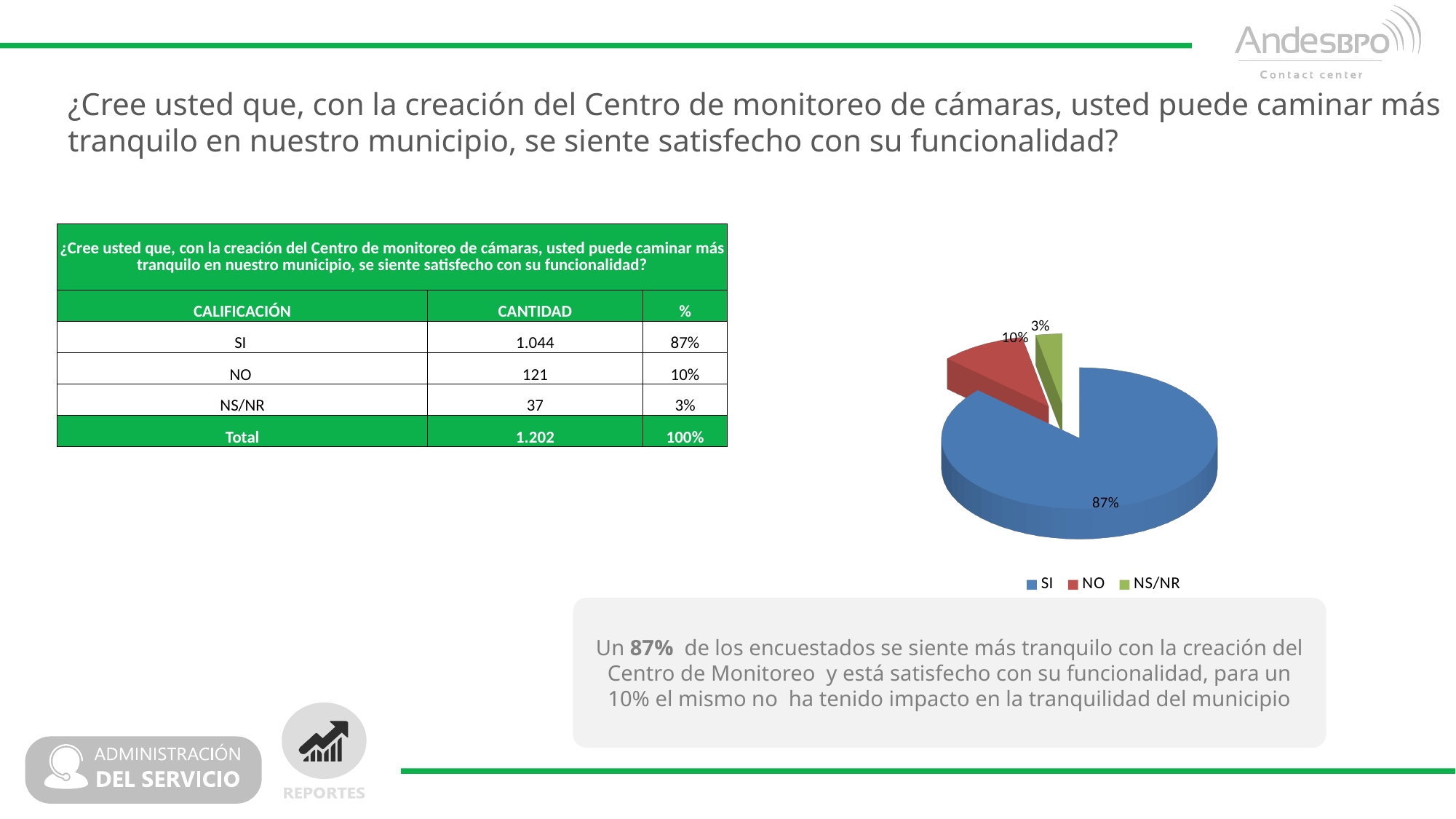
What colour is the SI slice in the pie chart? blue What share of the pie does the SI slice represent? 87% How many slices does the pie chart have? 3 What is the difference in percentage points between the SI slice and the NO slice? 77% How many entries does the legend list? 3 What kind of chart is shown on the slide? pie chart Which category has the largest slice of the pie? SI What colour is the NS/NR slice in the pie chart? green What share of the pie does the NS/NR slice represent? 3% What share of the pie does the NO slice represent? 10% Which slice is larger, NO or NS/NR? NO Which category has the smallest slice of the pie? NS/NR